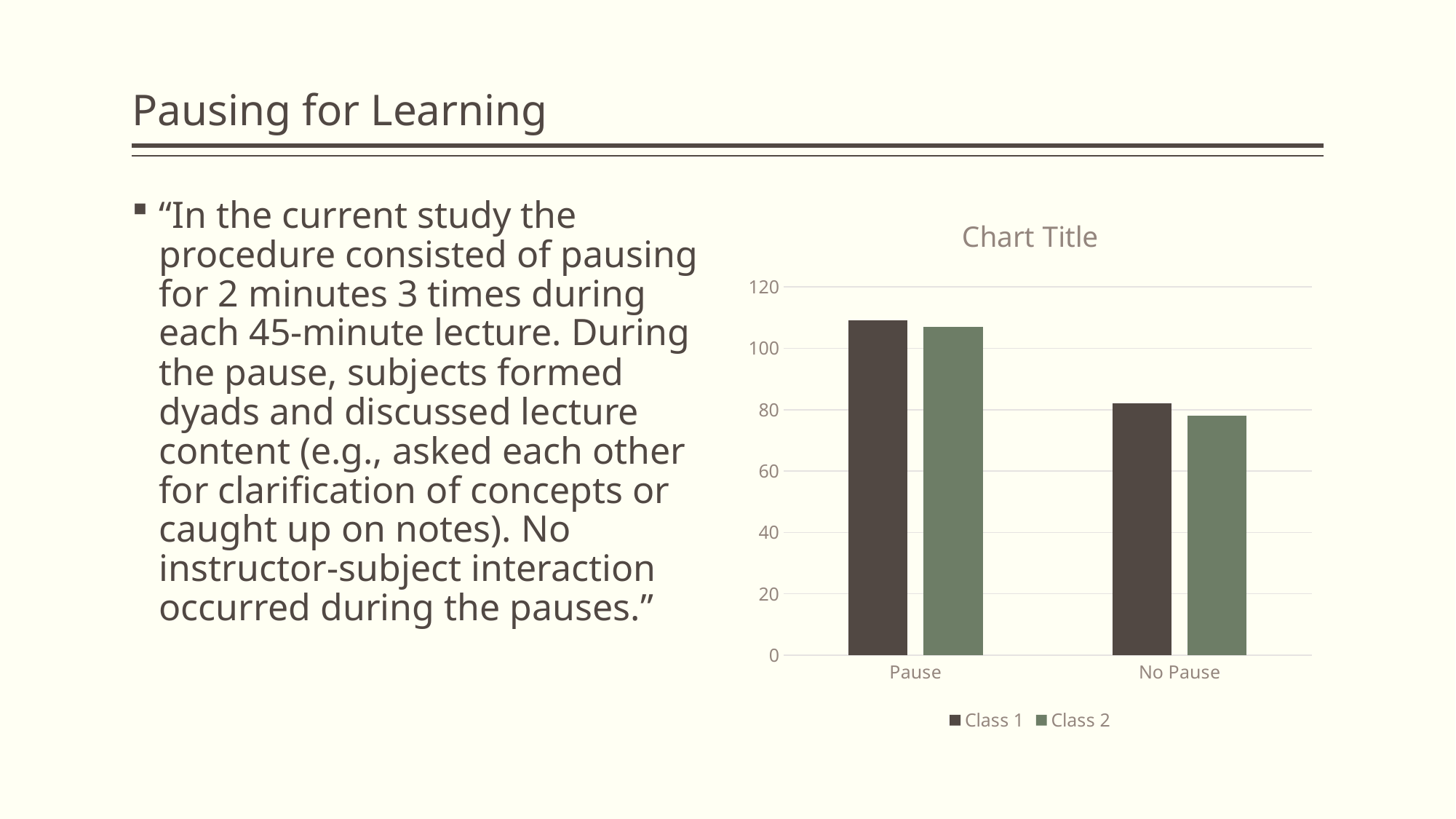
What is the title shown above the chart? Chart Title For Class 2, which category has the lower value? No Pause Is the Class 1 value for No Pause greater or less than 100? less Is the Class 2 value for Pause greater or less than 100? greater How many series does the chart's legend list? 2 Is the Class 2 value for No Pause greater or less than 60? greater What kind of chart is shown on the slide? bar chart For Class 1, which category has the higher value, Pause or No Pause? Pause What are the names of the series in the chart's legend? Class 1 and Class 2 How many categories are shown on the x axis of the chart? 2